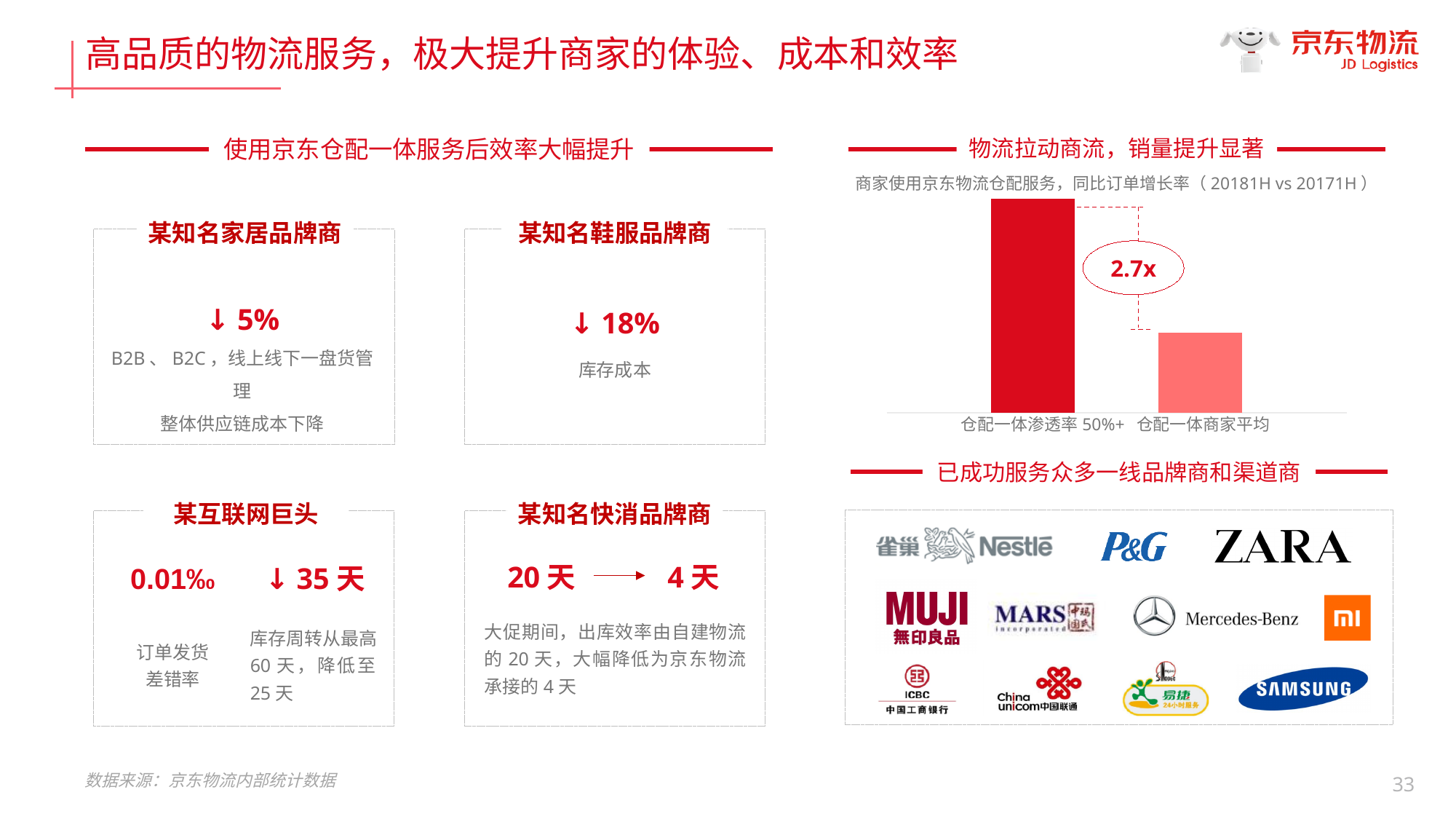
How many bars does the bar chart on the right side of the slide have? 2 In the bar chart, which category has the shorter bar? 仓配一体商家平均 What multiple is printed in the circle between the two bars of the bar chart? 2.7x In the bar chart, is the bar for 仓配一体渗透率 50%+ taller or shorter than the bar for 仓配一体商家平均? taller What is the title printed above the bar chart? 商家使用京东物流仓配服务，同比订单增长率（20181H vs 20171H） In the bar chart, which category has the taller bar? 仓配一体渗透率 50%+ What kind of chart is shown under the heading 物流拉动商流，销量提升显著? bar chart